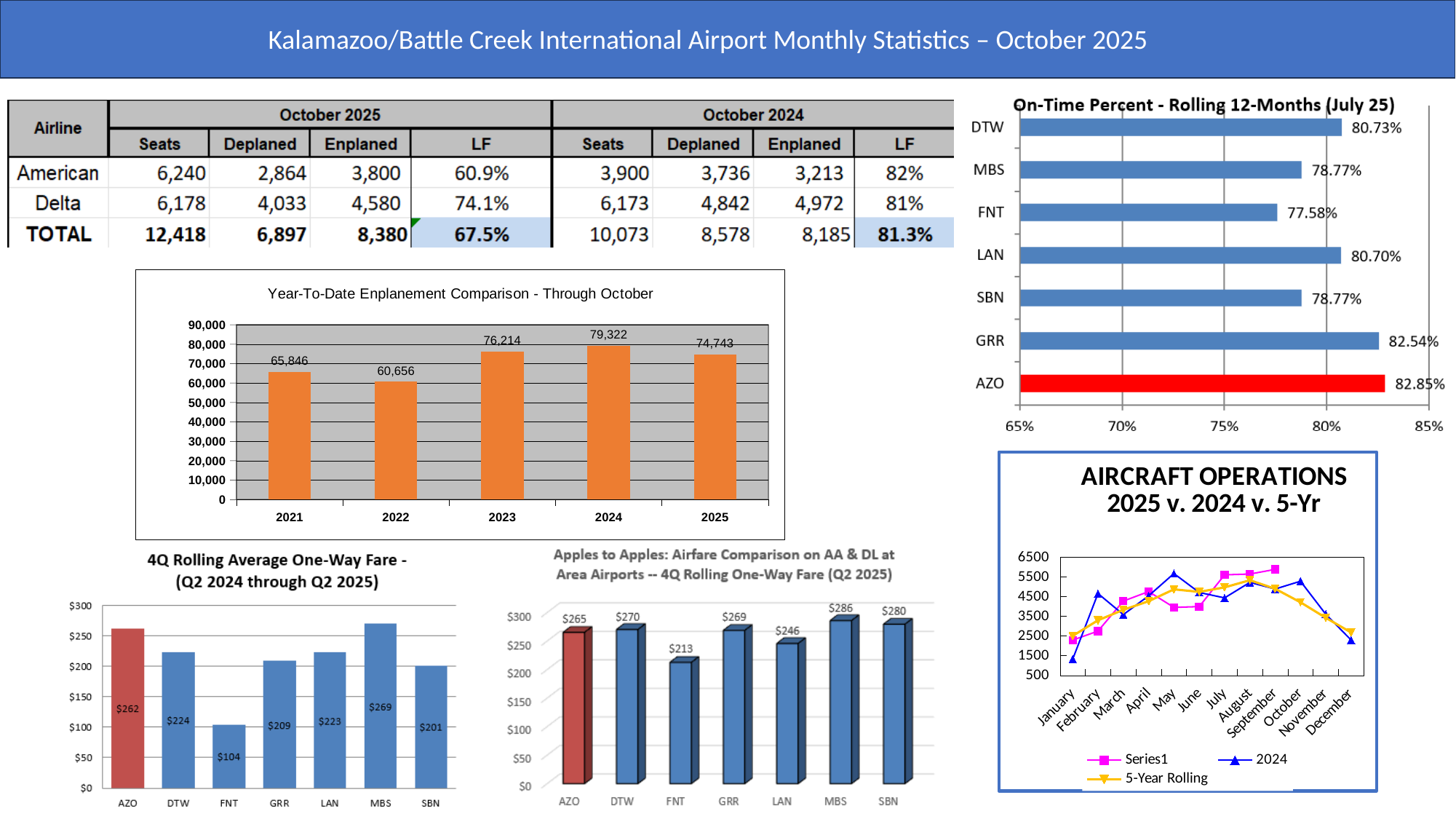
How many series does the legend of the Aircraft Operations chart list? 3 In the Apples to Apples airfare comparison chart, which is larger, the fare for MBS or for SBN? MBS In the Year-To-Date Enplanement Comparison chart, what is the difference between the 2024 and 2025 values? 4,579 In the On-Time Percent - Rolling 12-Months chart, which airport has the lowest on-time percent? FNT What kind of chart is the Aircraft Operations chart? line chart In the 4Q Rolling Average One-Way Fare chart, which airport has the highest fare? MBS In the Year-To-Date Enplanement Comparison chart, which year has the highest enplanements? 2024 In the Year-To-Date Enplanement Comparison chart, what is the value for 2024? 79,322 How many months are shown on the x axis of the Aircraft Operations chart? 12 In the 4Q Rolling Average One-Way Fare chart, what is the fare for FNT? $104 In the Apples to Apples airfare comparison chart, what is the difference between the DTW and AZO fares? $5 In the On-Time Percent - Rolling 12-Months chart, what is the value for AZO? 82.85%